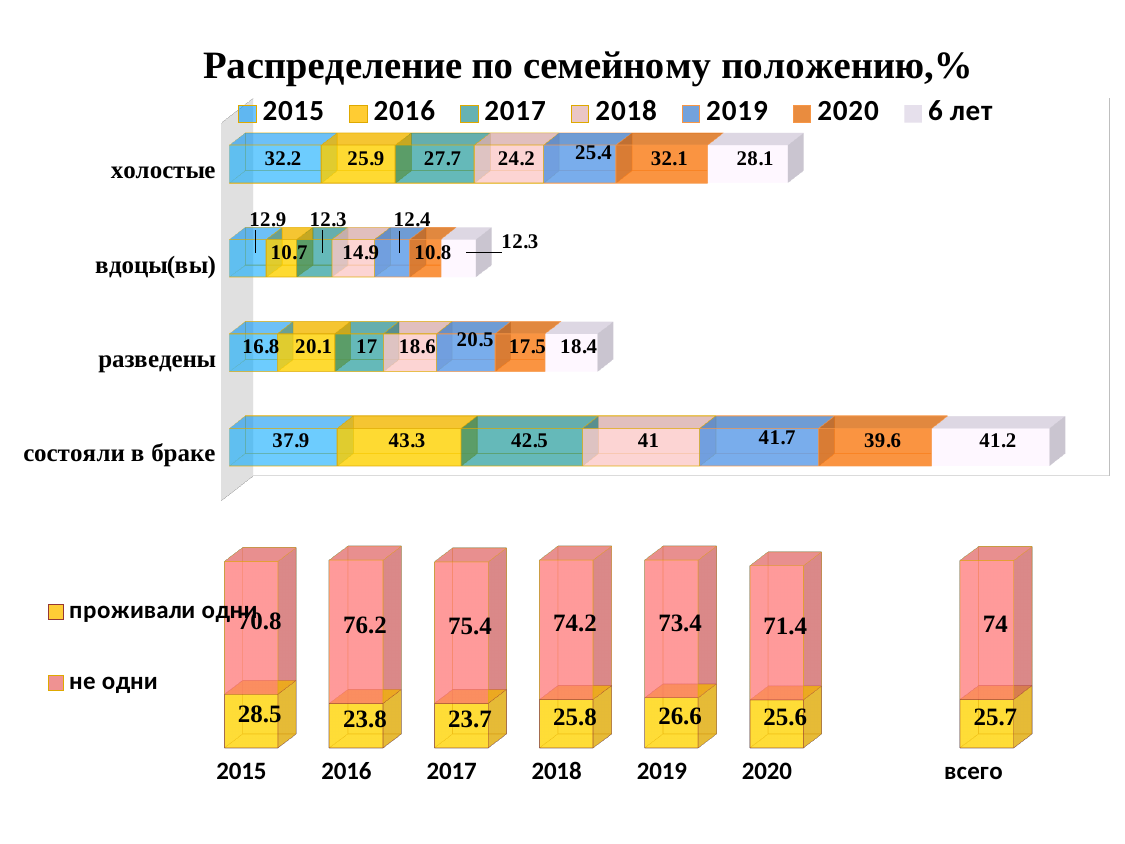
What kind of chart is the bottom chart on the slide? bar chart In the top chart 'Распределение по семейному положению,%', what is the difference between the 2015 values for 'холостые' and 'вдовцы(вы)'? 19.3 In the bottom chart, what is the 'проживали одни' value for 'всего'? 25.7 In the bottom chart, what is the 'не одни' value for 2016? 76.2 In the top chart 'Распределение по семейному положению,%', which year has the highest value for 'разведены'? 2019 In the top chart 'Распределение по семейному положению,%', what is the '6 лет' value for 'холостые'? 28.1 In the top chart 'Распределение по семейному положению,%', what is the 2016 value for 'состояли в браке'? 43.3 In the bottom chart, what is the total of the stacked bar for 2018? 100 How many series does the legend of the top chart 'Распределение по семейному положению,%' list? 7 In the bottom chart, which year has the highest 'проживали одни' value? 2015 How many categories are shown on the vertical axis of the top chart 'Распределение по семейному положению,%'? 4 In the bottom chart, which is larger: the 'проживали одни' value for 2019 or for 2020? 2019